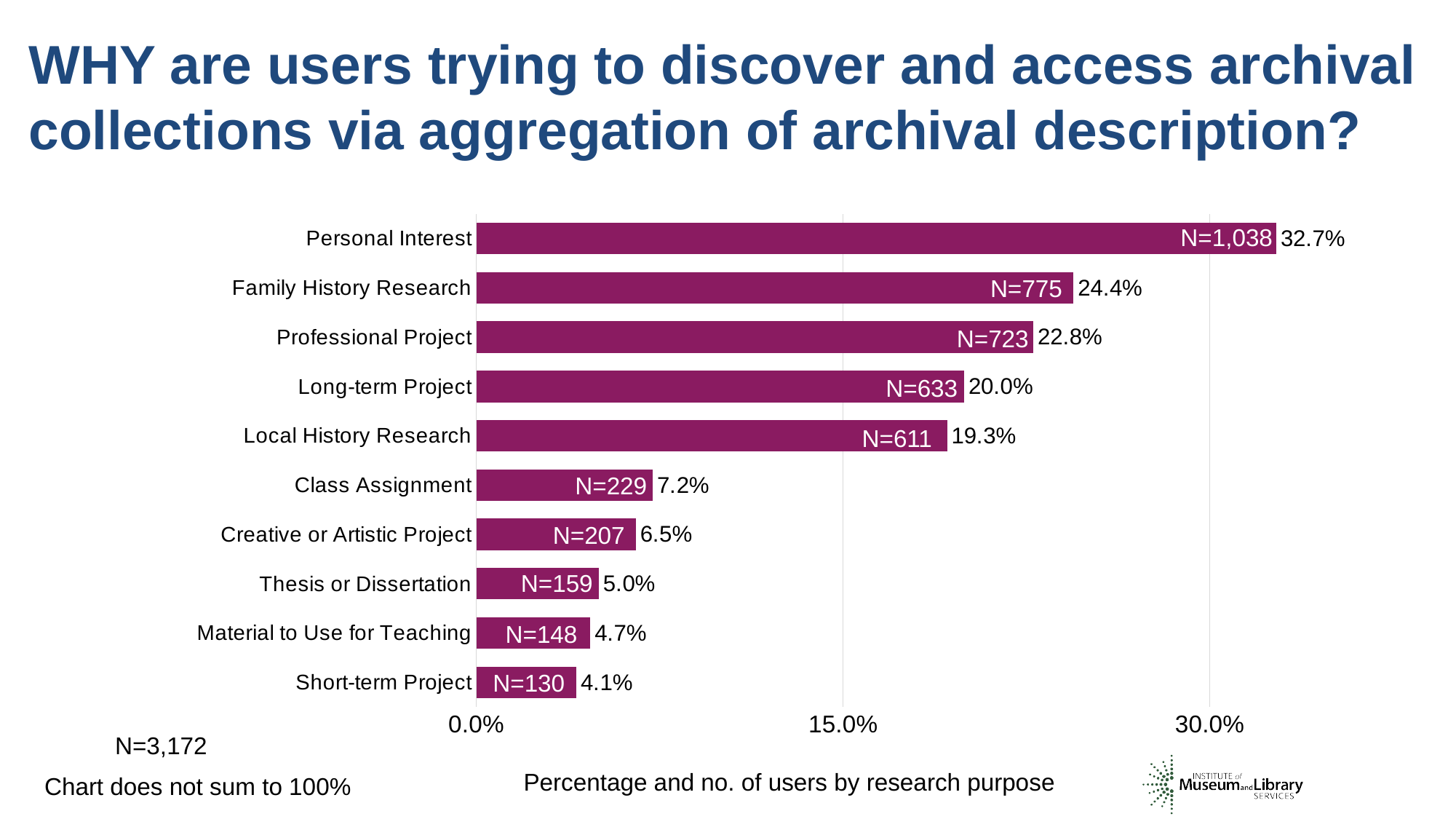
Which research purpose has the highest percentage of users? Personal Interest What is the total N reported below the chart? N=3,172 What kind of chart is shown on the slide? Bar chart How many users (N) selected Family History Research? N=775 What is the caption printed beneath the chart's x axis? Percentage and no. of users by research purpose What is the difference in percentage points between Personal Interest and Family History Research? 8.3 What percentage of users selected Thesis or Dissertation? 5.0% What percentage of users selected Personal Interest as their research purpose? 32.7% How many research purpose categories are shown in the chart? 10 Which has a larger percentage of users: Class Assignment or Creative or Artistic Project? Class Assignment Is the value for Long-term Project greater or less than 15.0%? greater Which research purpose has the lowest percentage of users? Short-term Project